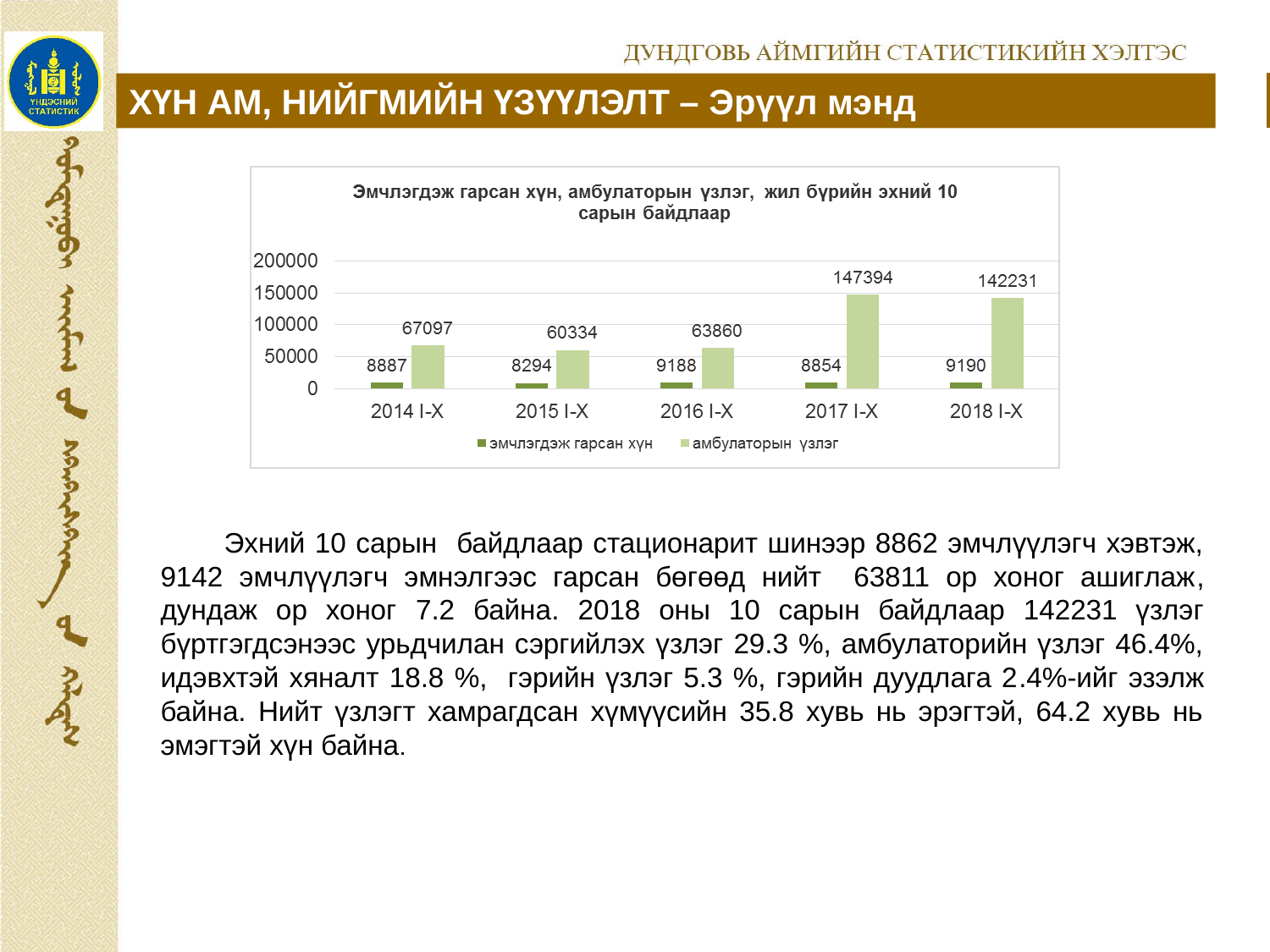
What is the value of эмчлэгдэж гарсан хүн for 2015 I-X? 8294 Which is larger: амбулаторын үзлэг in 2016 I-X or in 2015 I-X? 2016 I-X What is the difference between амбулаторын үзлэг in 2017 I-X and 2018 I-X? 5163 What is the value of амбулаторын үзлэг for 2014 I-X? 67097 What is the value of эмчлэгдэж гарсан хүн for 2018 I-X? 9190 What kind of chart is shown on the slide? bar chart How many series does the legend list? 2 What is the value of амбулаторын үзлэг for 2017 I-X? 147394 Is the value of амбулаторын үзлэг for 2018 I-X greater or less than 100000? greater How many periods are shown on the x axis? 5 Which period has the highest value for амбулаторын үзлэг? 2017 I-X Which period has the lowest value for эмчлэгдэж гарсан хүн? 2015 I-X